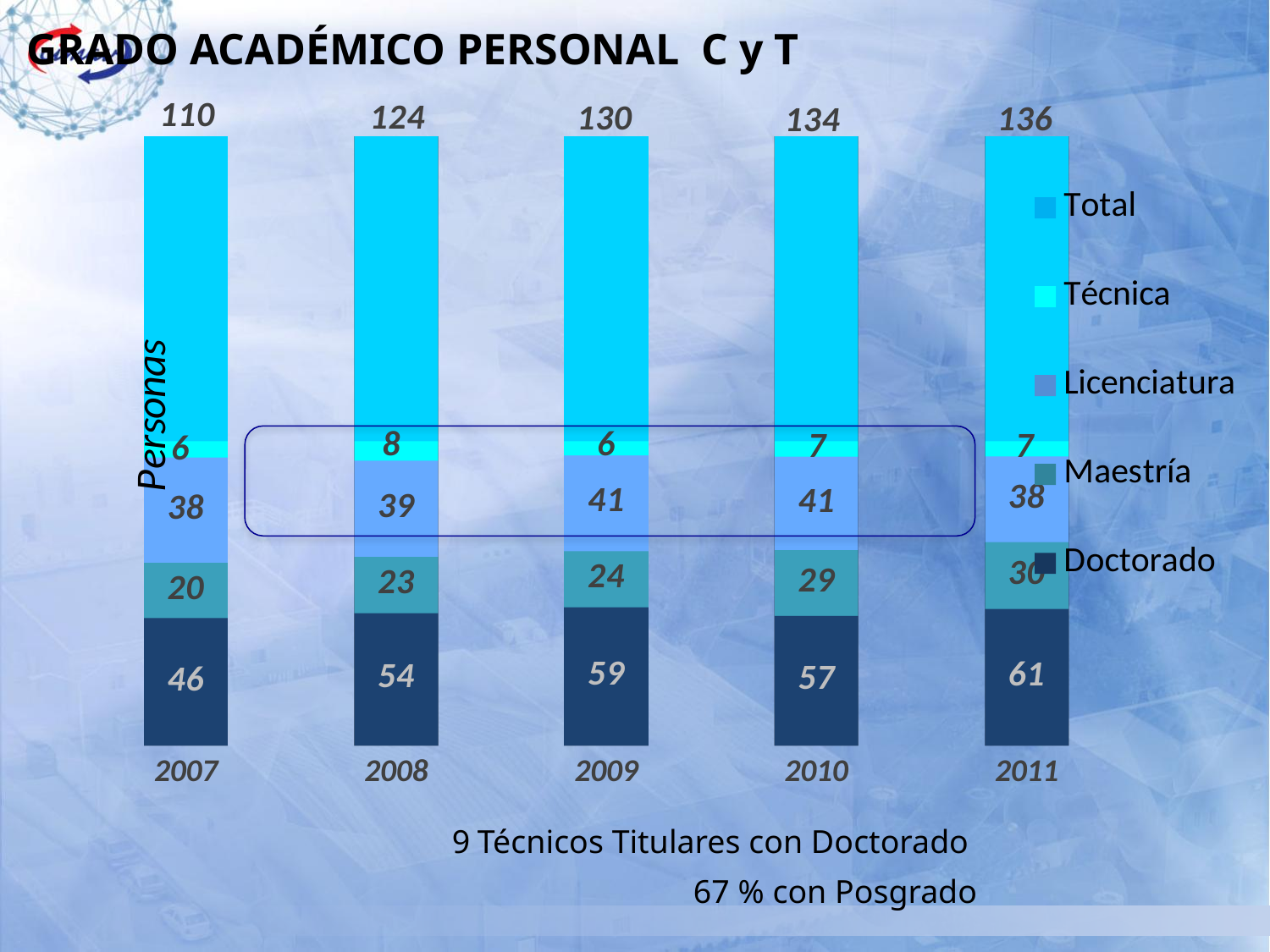
How many years are shown on the x axis? 5 Do the total values labeled above the bars rise or fall from 2007 to 2011? Rise What kind of chart is shown? Stacked bar chart How many series does the legend list? 5 Which year has the highest Doctorado value? 2011 What is the Técnica value for 2010? 7 What is the Maestría value for 2009? 24 What is the Doctorado value for 2011? 61 What is the Licenciatura value for 2008? 39 Which year has the lowest Maestría value? 2007 What is the difference between the Doctorado values for 2008 and 2007? 8 Which is larger, the Maestría value for 2010 or for 2009? 2010